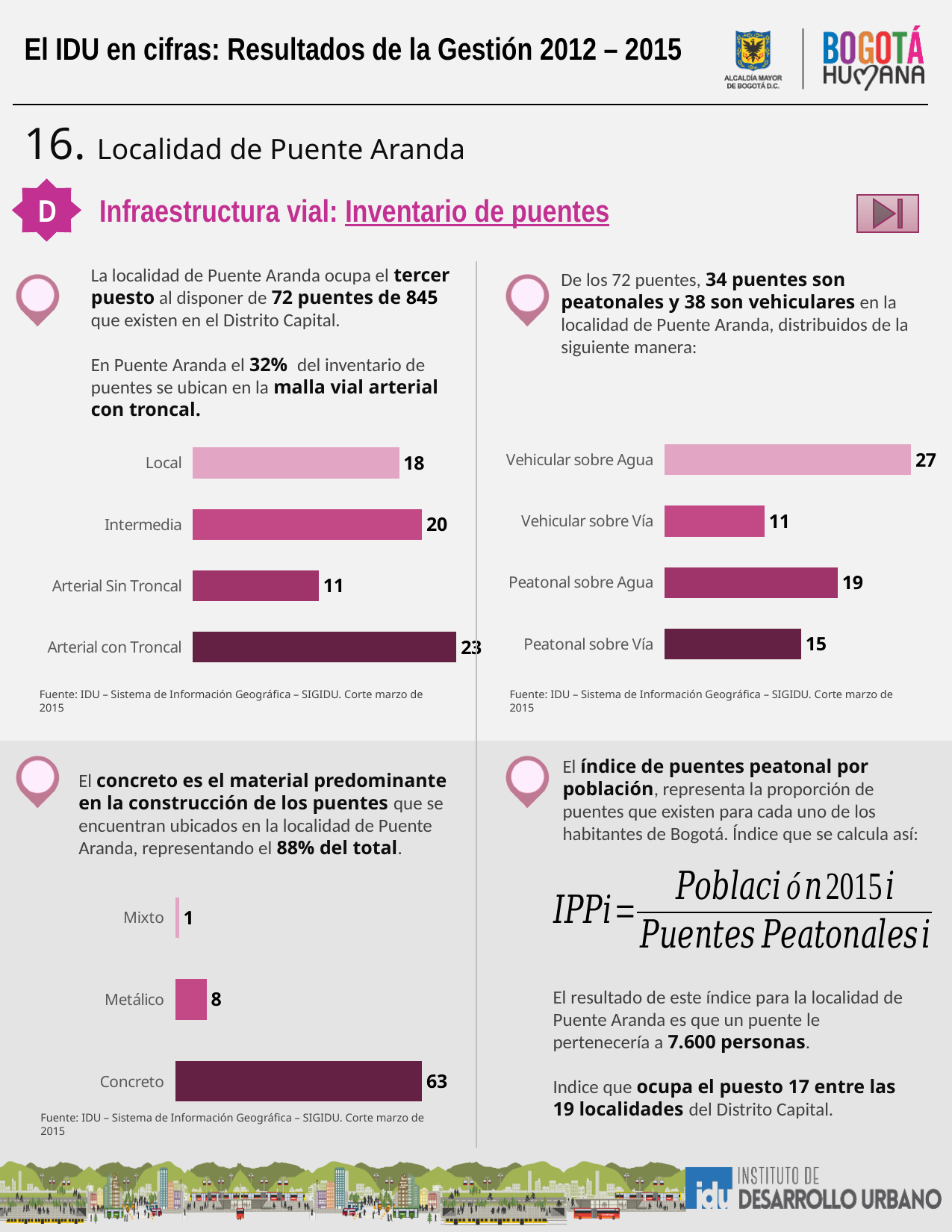
In the top-right bar chart, which category has the highest value? Vehicular sobre Agua In the top-right bar chart, what is the difference between Peatonal sobre Agua and Vehicular sobre Vía? 8 In the top-left bar chart, what is the difference between Intermedia and Local? 2 In the top-right bar chart, which is larger: Peatonal sobre Agua or Peatonal sobre Vía? Peatonal sobre Agua In the bottom-left bar chart, what is the value for Concreto? 63 In the top-left bar chart, which category has the lowest value? Arterial Sin Troncal How many categories does the top-left bar chart show? 4 In the top-right bar chart, what is the value for Vehicular sobre Agua? 27 What type of chart is the bottom-left chart? Bar chart In the top-left bar chart, what is the value for Arterial con Troncal? 23 In the bottom-left bar chart, which category has the lowest value? Mixto How many categories does the bottom-left bar chart show? 3